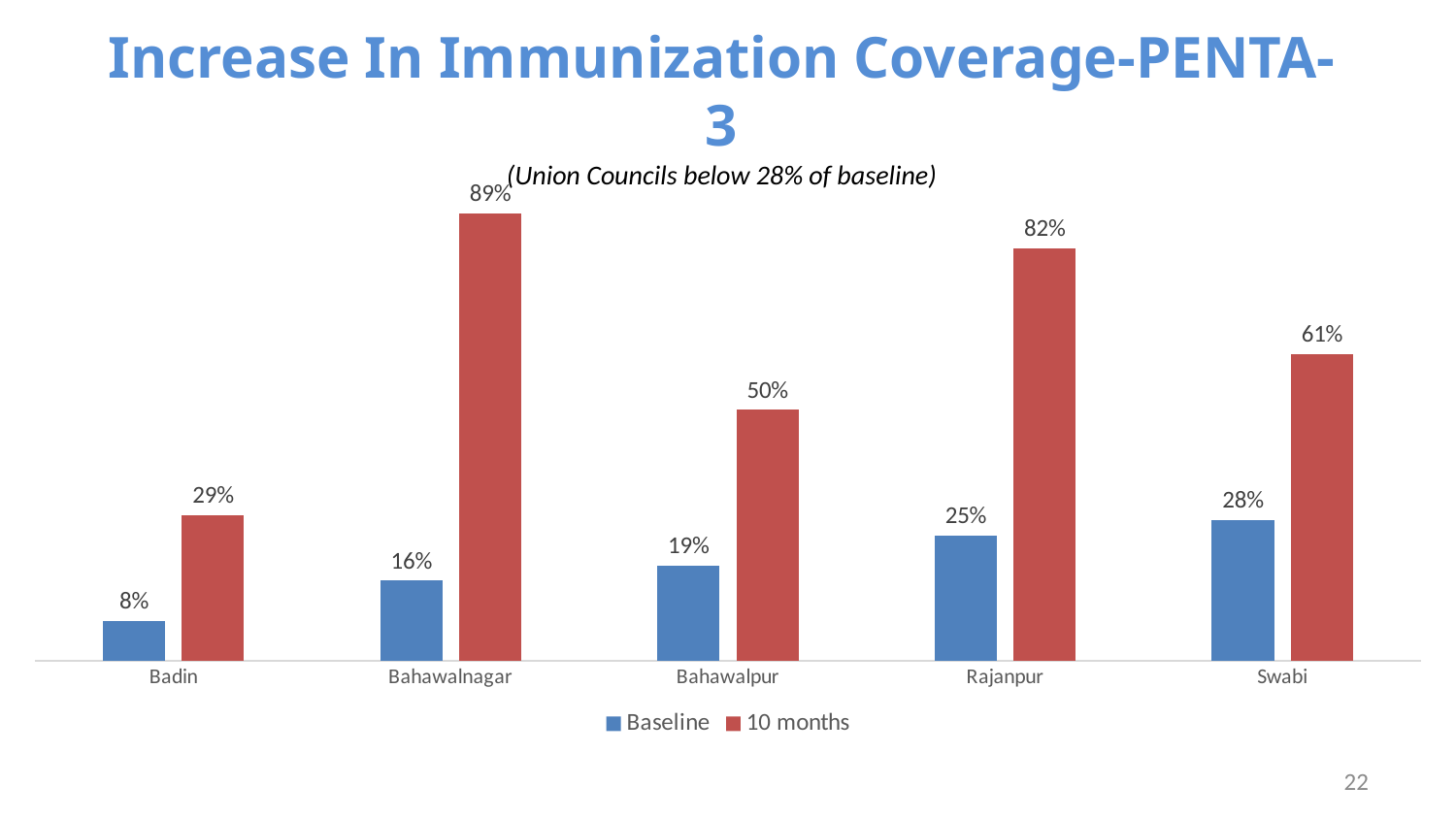
What kind of chart is shown on the slide? Bar chart What is the Baseline value for Swabi? 28% How many series does the legend list? 2 What is the difference between the 10 months and Baseline values for Bahawalpur? 31% What are the two series listed in the legend? Baseline and 10 months Which district has the lowest Baseline value? Badin Which is larger, the 10 months value for Swabi or the 10 months value for Bahawalpur? Swabi Which district has the highest 10 months value? Bahawalnagar What is the Baseline value for Badin? 8% What is the 10 months value for Rajanpur? 82% What is the 10 months value for Bahawalnagar? 89% How many districts are shown on the x axis? 5